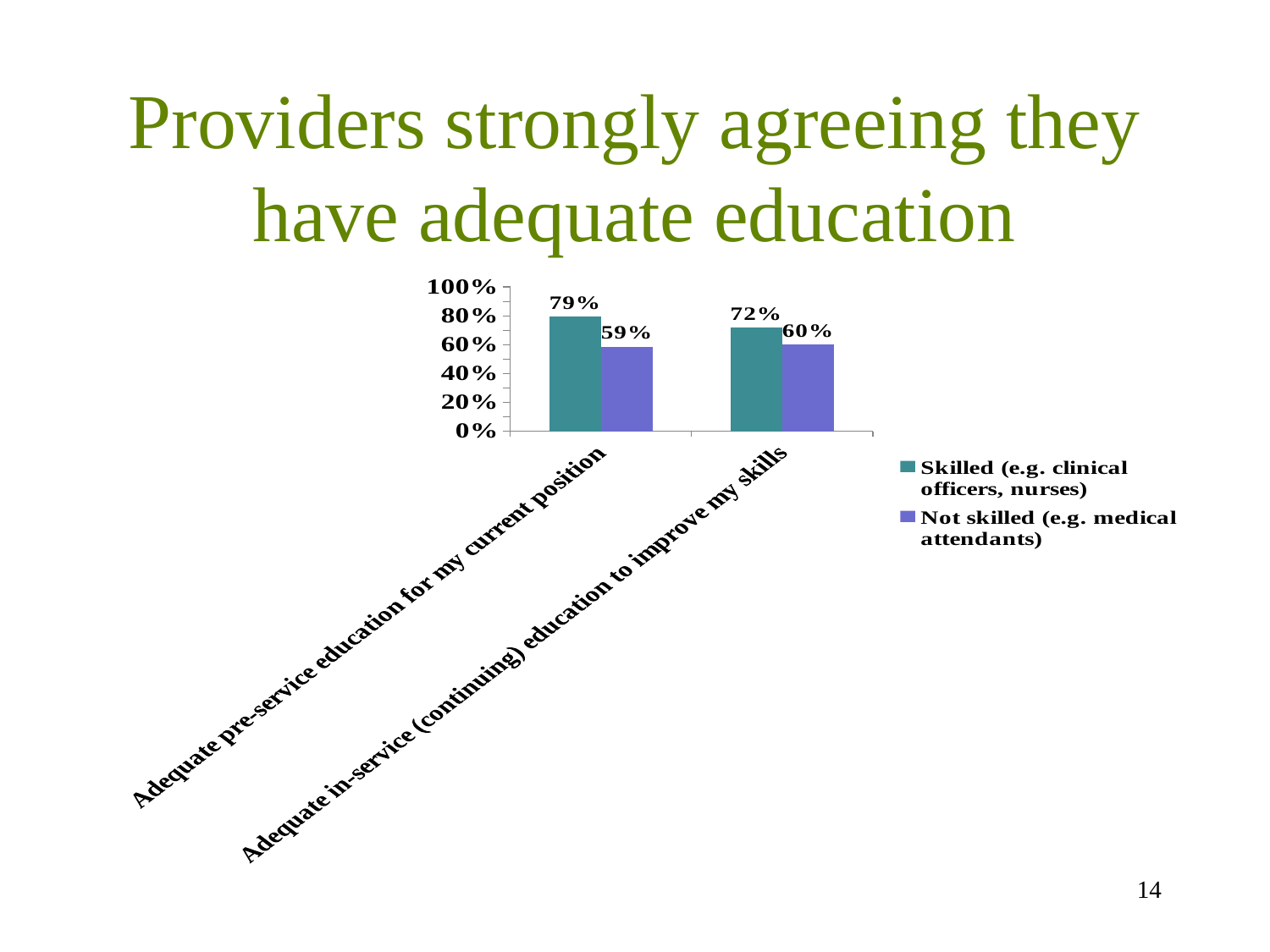
What is the difference between skilled and not skilled providers for adequate in-service (continuing) education to improve my skills? 12 percentage points What is the difference between skilled and not skilled providers for adequate pre-service education for my current position? 20 percentage points What kind of chart is shown on the slide? Bar chart What is the value for not skilled providers on adequate pre-service education for my current position? 59% What percentage of skilled providers strongly agreed they have adequate pre-service education for their current position? 79% How many categories are shown on the x axis of the chart? 2 Which series is shown in purple in the chart? Not skilled (e.g. medical attendants) Which bar in the chart has the highest value? Skilled, adequate pre-service education for my current position (79%) What percentage of not skilled providers strongly agreed they have adequate in-service (continuing) education to improve their skills? 60% How many series does the legend list? 2 For adequate in-service (continuing) education to improve my skills, which group has the larger value, skilled or not skilled? Skilled What is the value for skilled providers on adequate in-service (continuing) education to improve my skills? 72%